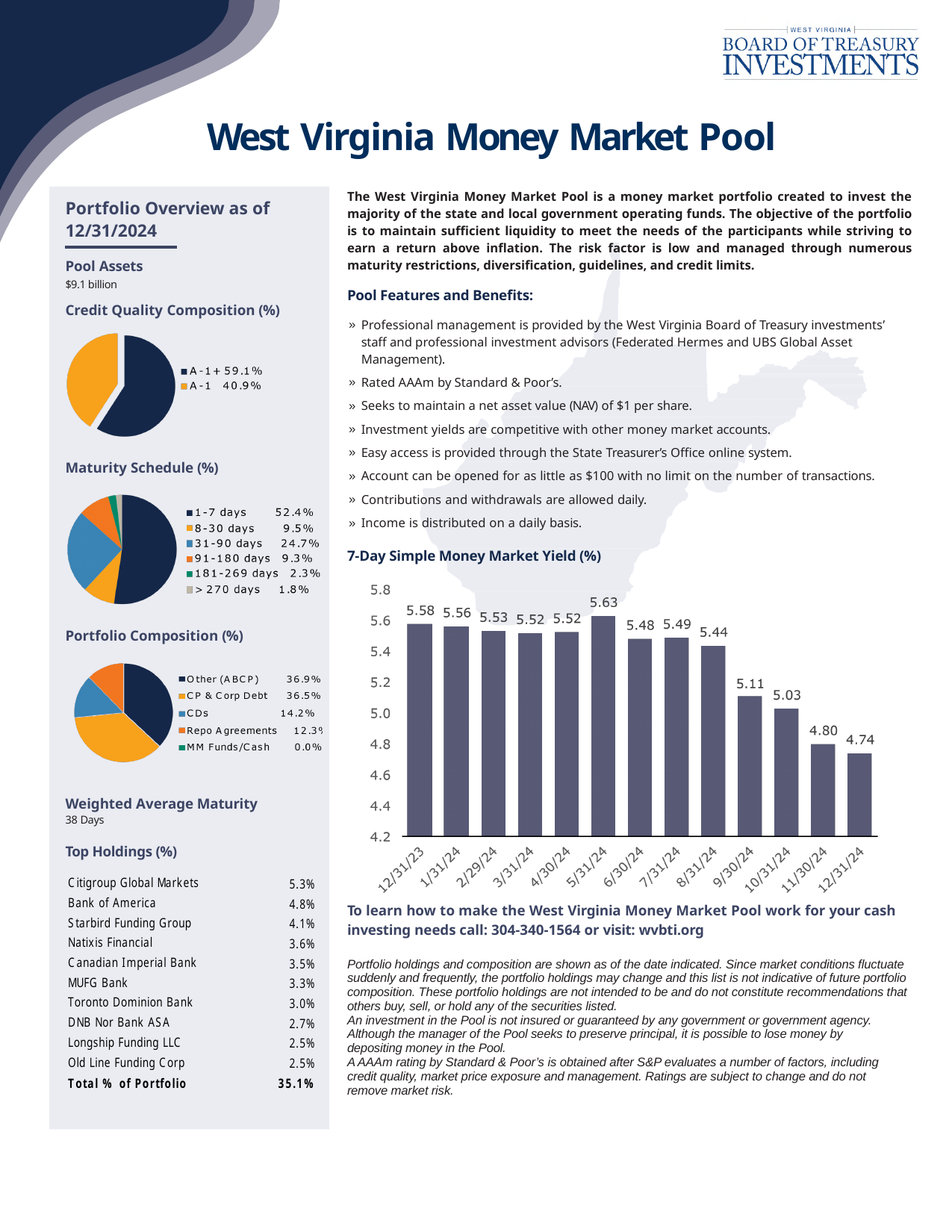
In the Credit Quality Composition pie chart, what share is A-1+? 59.1% In the 7-Day Simple Money Market Yield chart, which date has the highest yield? 5/31/24 In the 7-Day Simple Money Market Yield chart, what is the value for 12/31/24? 4.74 In the Maturity Schedule pie chart, what is the value for 31-90 days? 24.7% In the Portfolio Composition pie chart, which is larger, CDs or Repo Agreements? CDs In the 7-Day Simple Money Market Yield chart, do the values generally rise or fall from 5/31/24 to 12/31/24? fall What kind of chart is the 7-Day Simple Money Market Yield chart? bar chart In the 7-Day Simple Money Market Yield chart, how many dates are plotted? 13 In the 7-Day Simple Money Market Yield chart, which date has the lowest yield? 12/31/24 In the 7-Day Simple Money Market Yield chart, what is the difference between the values for 12/31/23 and 12/31/24? 0.84 In the Maturity Schedule pie chart, which category has the smallest share? > 270 days In the 7-Day Simple Money Market Yield chart, what is the value for 5/31/24? 5.63